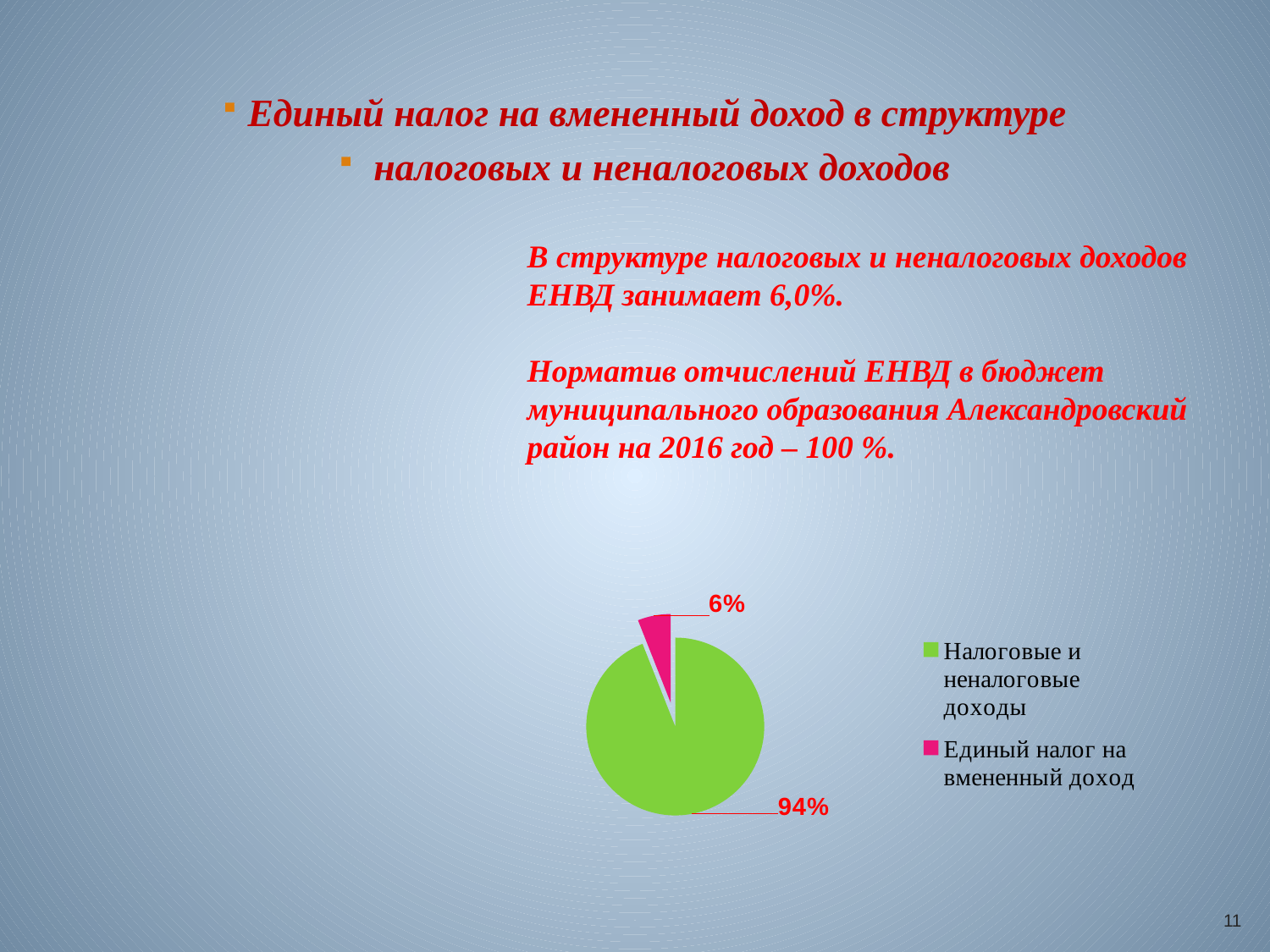
Which slice of the pie is the smallest? Единый налог на вмененный доход How many entries does the legend list? 2 What share of the pie does "Налоговые и неналоговые доходы" take? 94% What share of the pie does "Единый налог на вмененный доход" take? 6% Which is larger: the slice for "Единый налог на вмененный доход" or the slice for "Налоговые и неналоговые доходы"? Налоговые и неналоговые доходы What kind of chart is shown on the slide? pie chart How many slices does the pie chart have? 2 What colour is the slice for "Налоговые и неналоговые доходы"? green Which slice of the pie is the largest? Налоговые и неналоговые доходы What is the difference in percentage points between the two slices of the pie? 88 What colour is the slice for "Единый налог на вмененный доход"? pink